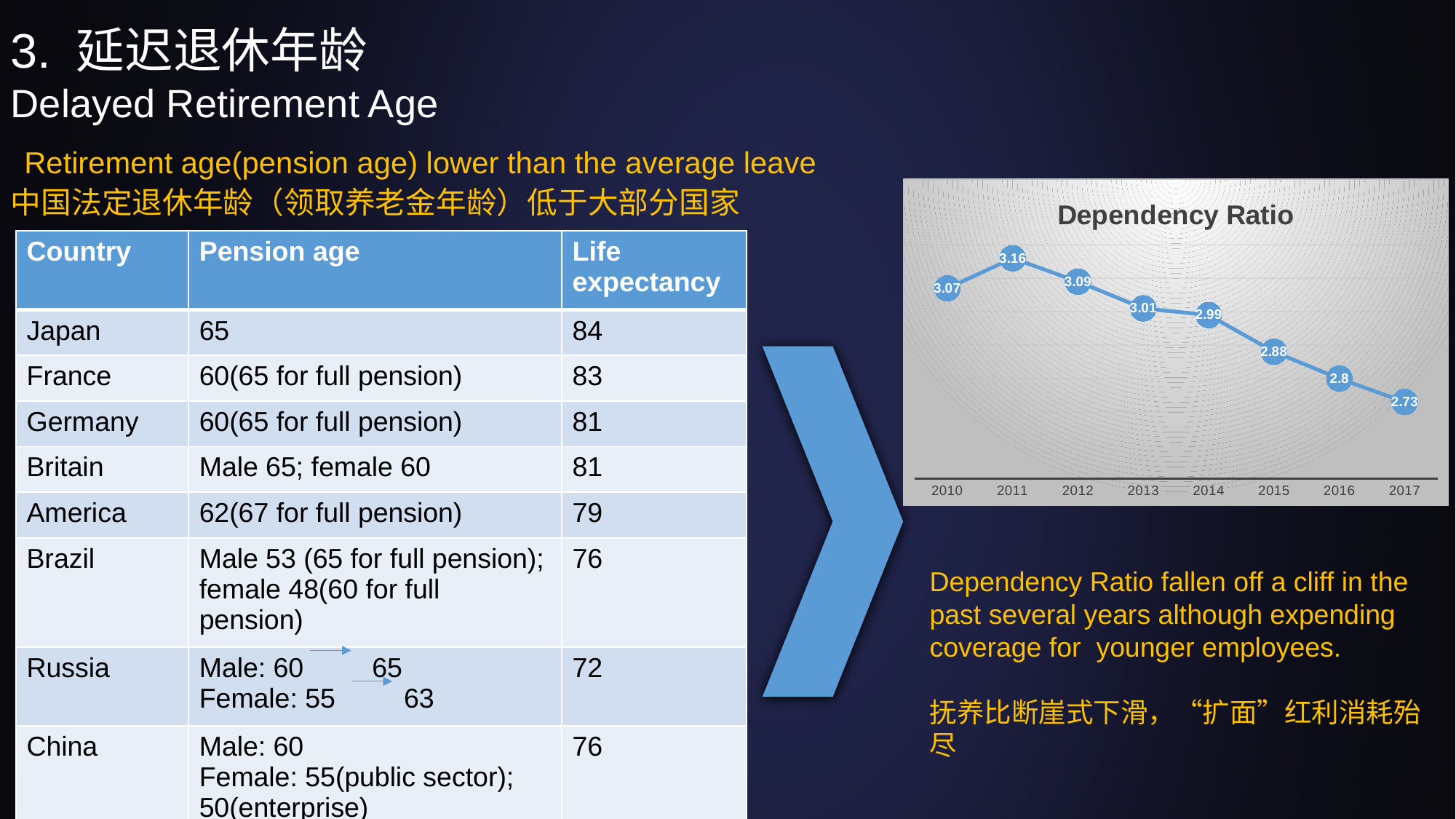
How many years are plotted on the Dependency Ratio chart? 8 Which is larger, the Dependency Ratio in 2012 or in 2015? 2012 What is the Dependency Ratio value for 2010? 3.07 Does the Dependency Ratio generally rise or fall from 2011 to 2017? fall What is the Dependency Ratio value for 2017? 2.73 What is the title of the chart on the slide? Dependency Ratio Which year has the highest Dependency Ratio? 2011 What is the Dependency Ratio value for 2014? 2.99 What is the difference between the Dependency Ratio in 2010 and in 2011? 0.09 What type of chart is the Dependency Ratio chart? line chart Which year has the lowest Dependency Ratio? 2017 What is the difference between the Dependency Ratio in 2011 and in 2017? 0.43